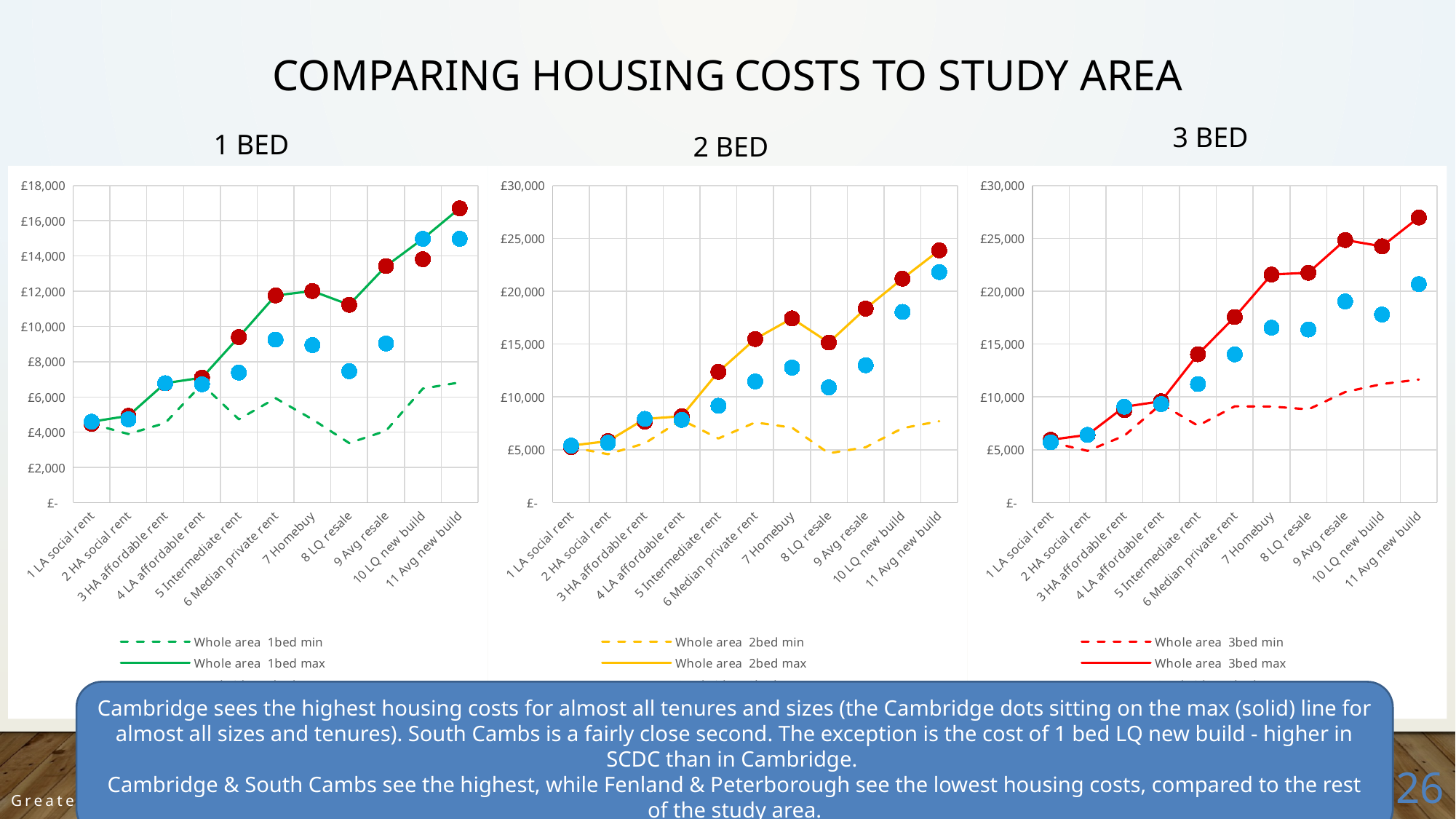
In the 3 BED chart, is the value of the solid max line for 7 Homebuy greater or less than £20,000? greater What kind of chart is the 1 BED chart? line chart What is the highest value shown on the y axis of the 1 BED chart? £18,000 In the 3 BED chart, is the value of the solid max line for 11 Avg new build greater or less than £25,000? greater In the 1 BED chart, is the value of the solid max line for 1 LA social rent greater or less than £6,000? less In the 3 BED chart, which category has the lowest value on the solid max line? 1 LA social rent In the 1 BED chart, which category has the highest value on the solid max line? 11 Avg new build How many categories are shown on the x axis of the 2 BED chart? 11 In the 3 BED chart, what is the legend label for the dashed line? Whole area 3bed min In the 2 BED chart, does the solid max line generally rise or fall from 1 LA social rent to 11 Avg new build? rise